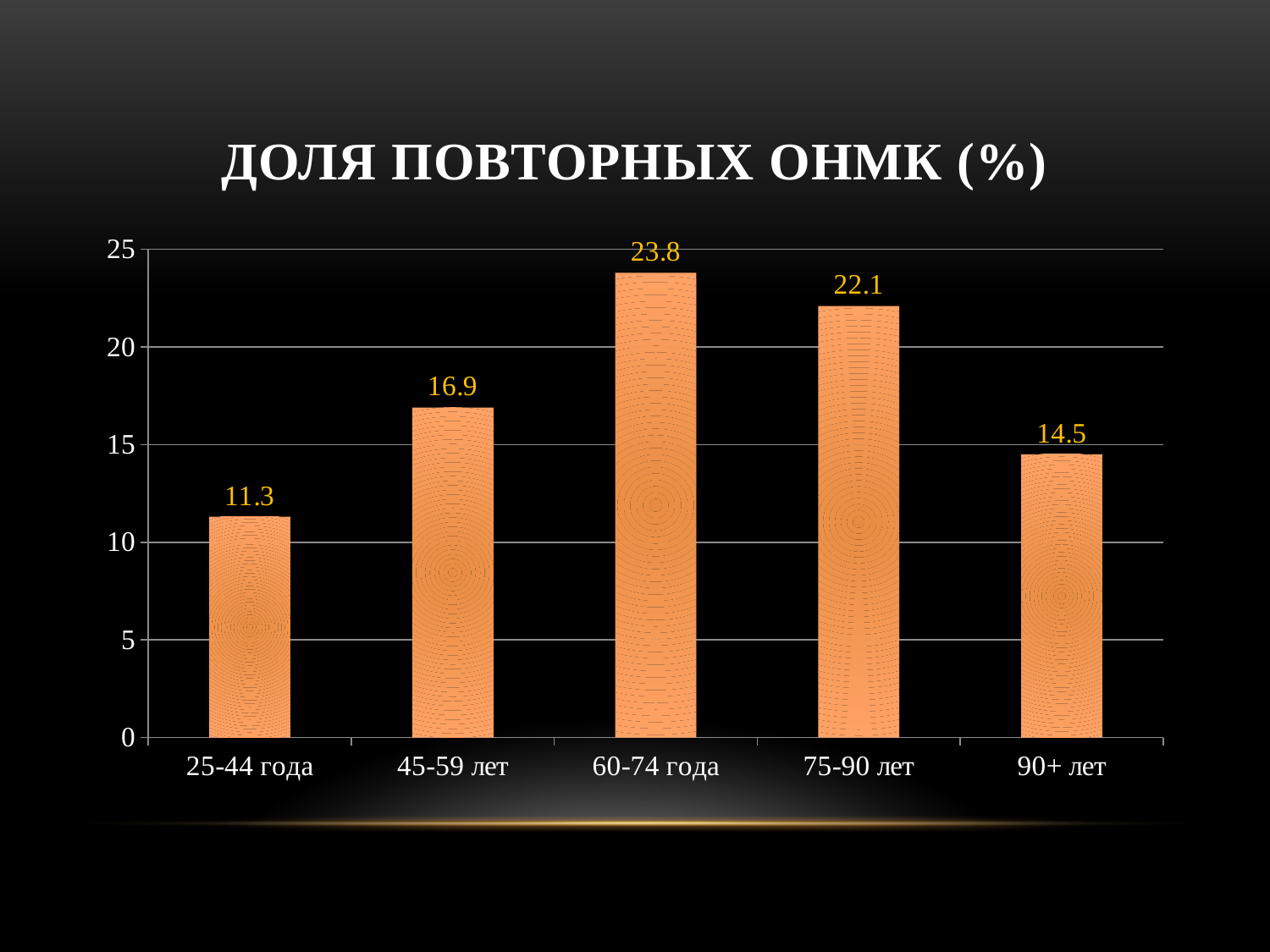
What is the difference between the values for 45-59 лет and 25-44 года? 5.6 What is the value for the 90+ лет category? 14.5 What is the value for the 25-44 года category? 11.3 Which is larger, the value for 45-59 лет or the value for 90+ лет? 45-59 лет Which age group has the lowest value? 25-44 года What is the value for the 60-74 года category? 23.8 What is the title of the chart? ДОЛЯ ПОВТОРНЫХ ОНМК (%) What is the difference between the values for 60-74 года and 75-90 лет? 1.7 What kind of chart is shown on the slide? bar chart Which age group has the highest value? 60-74 года Is the value for 75-90 лет greater or less than 20? greater How many age categories are shown on the x axis? 5